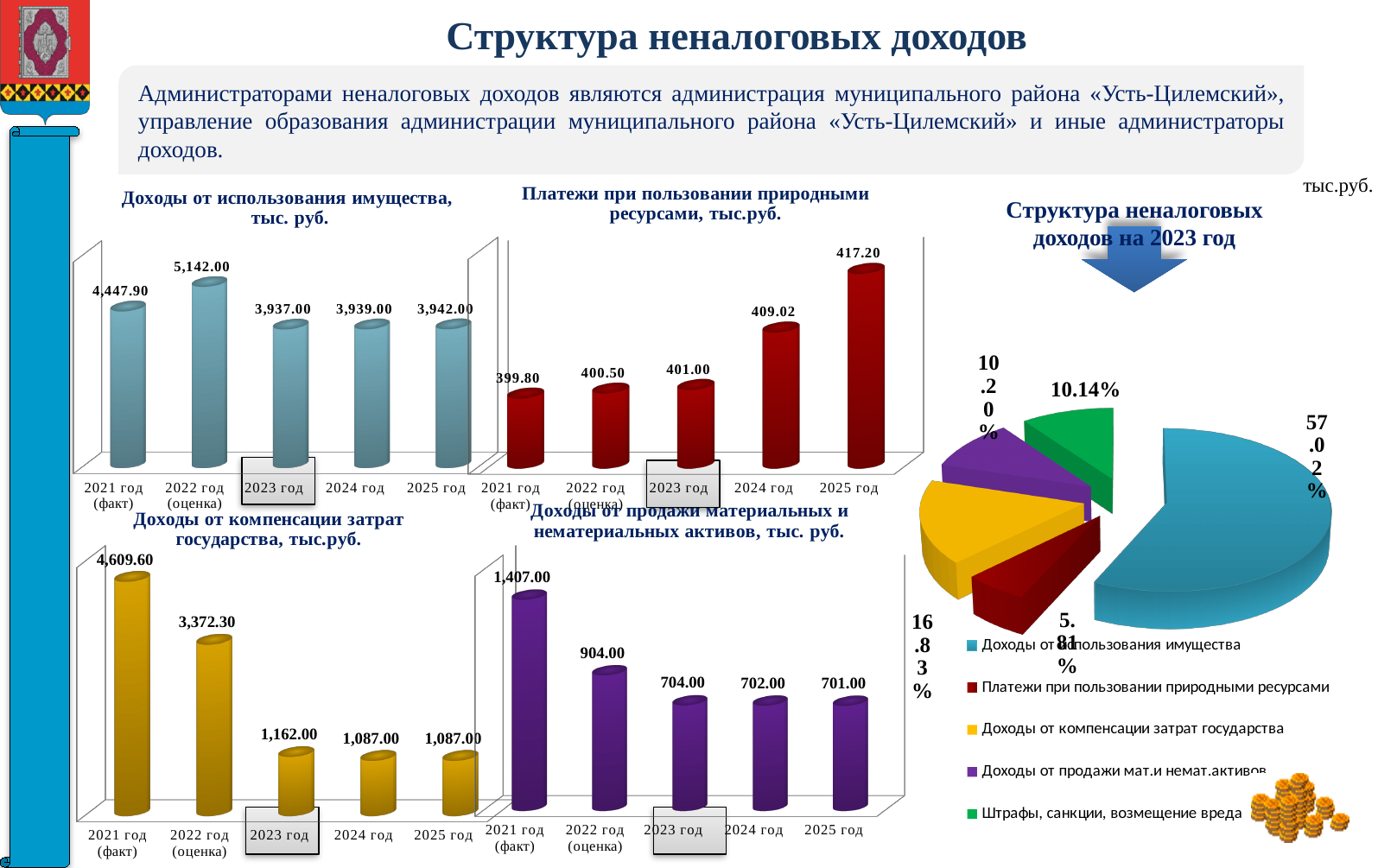
How many entries does the legend of the pie chart 'Структура неналоговых доходов на 2023 год' list? 5 In the pie chart 'Структура неналоговых доходов на 2023 год', what share is 'Доходы от использования имущества'? 57.02% In the chart 'Доходы от продажи материальных и нематериальных активов, тыс. руб.', which year has the lowest value? 2025 год In the chart 'Доходы от использования имущества, тыс. руб.', which year has the highest value? 2022 год (оценка) In the chart 'Платежи при пользовании природными ресурсами, тыс.руб.', do the values rise or fall from 2021 to 2025? rise In the chart 'Доходы от компенсации затрат государства, тыс.руб.', what is the difference between 2022 год (оценка) and 2023 год? 2,210.30 In the chart 'Доходы от компенсации затрат государства, тыс.руб.', what is the value for 2021 год (факт)? 4,609.60 In the chart 'Платежи при пользовании природными ресурсами, тыс.руб.', what is the value for 2025 год? 417.20 In the chart 'Доходы от использования имущества, тыс. руб.', what is the value for 2022 год (оценка)? 5,142.00 In the chart 'Доходы от продажи материальных и нематериальных активов, тыс. руб.', which is larger: 2021 год (факт) or 2022 год (оценка)? 2021 год (факт) What kind of chart is 'Доходы от компенсации затрат государства, тыс.руб.'? bar chart In the chart 'Доходы от продажи материальных и нематериальных активов, тыс. руб.', what is the value for 2023 год? 704.00